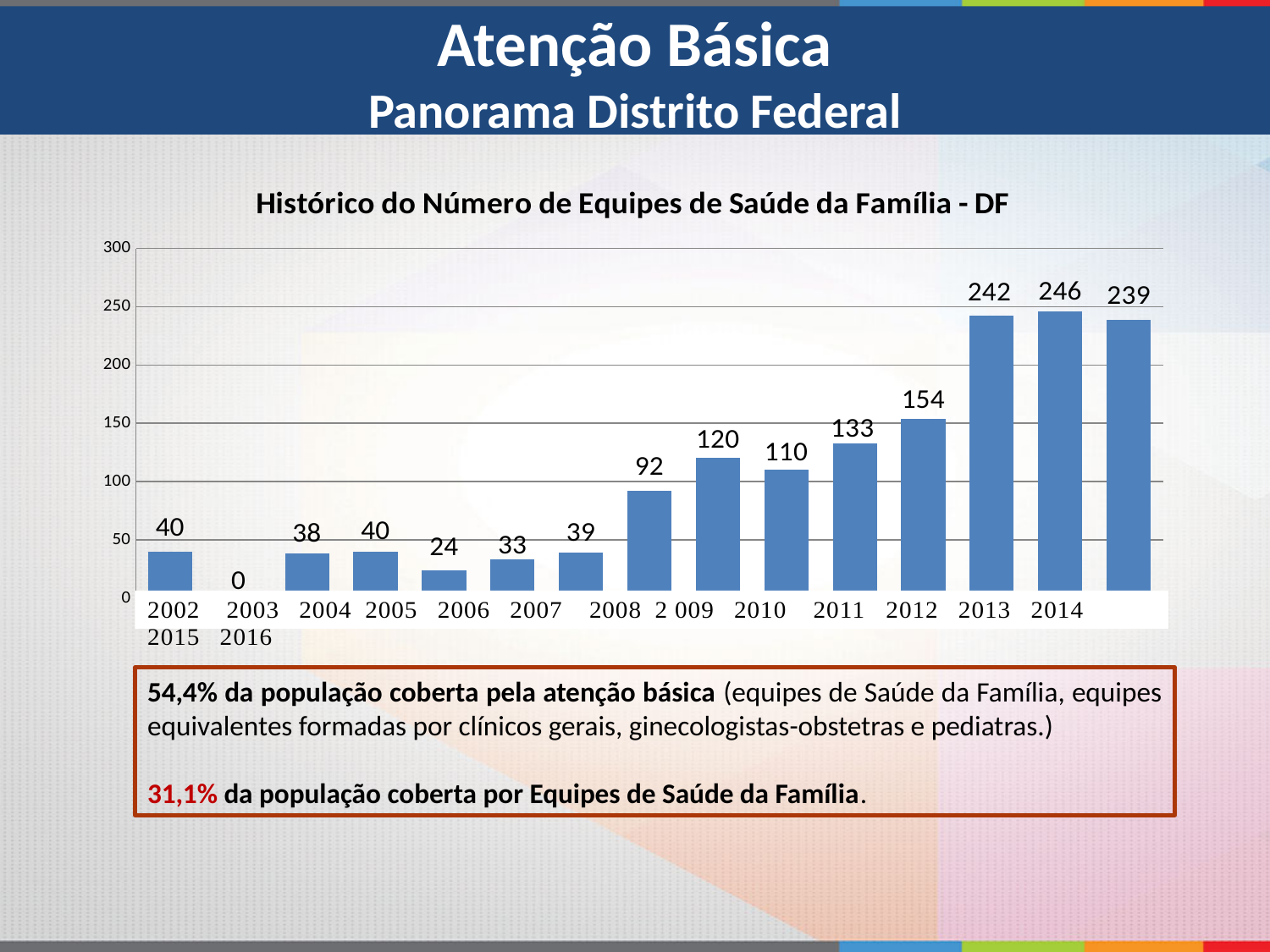
What is the difference between the values for 2014 and 2013? 88 What is the value for 2014? 242 What is the title of the chart? Histórico do Número de Equipes de Saúde da Família - DF Which is larger, the value for 2010 or the value for 2011? 2010 What is the value for 2013? 154 What is the value for 2009? 92 Which year has the lowest value? 2003 How many bars (years) are plotted in the chart? 15 What is the highest value shown in the chart? 246 What is the value for 2002? 40 Do the values rise or fall from 2011 to 2014? rise What type of chart is shown on the slide? bar chart